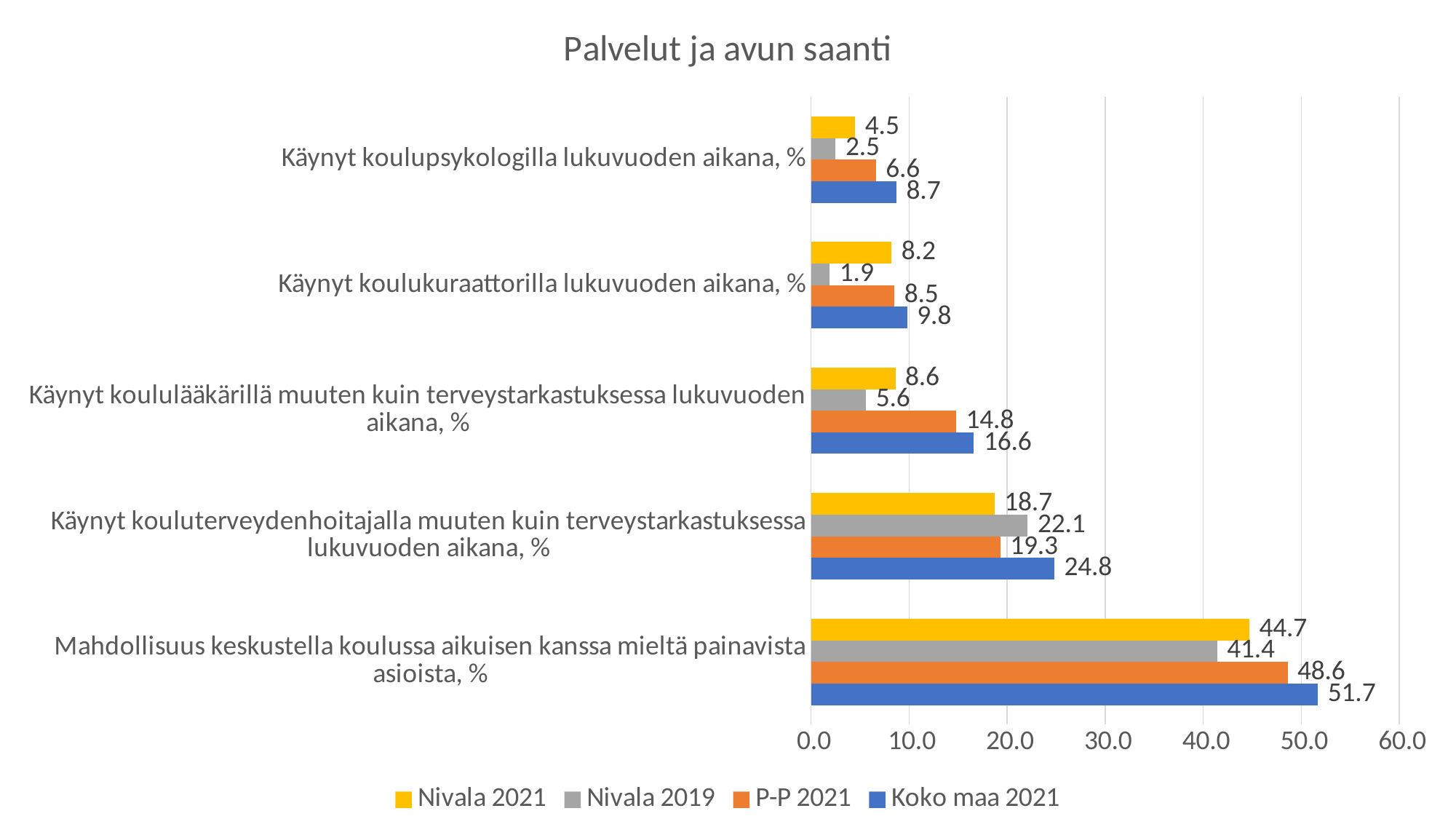
How many categories are shown on the chart? 5 Which series has the lowest value in the category "Käynyt koululääkärillä muuten kuin terveystarkastuksessa lukuvuoden aikana, %"? Nivala 2019 What is the value for Nivala 2021 in the category "Käynyt koulupsykologilla lukuvuoden aikana, %"? 4.5 Is the Koko maa 2021 value for "Mahdollisuus keskustella koulussa aikuisen kanssa mieltä painavista asioista, %" greater or less than 50.0? greater In the category "Käynyt kouluterveydenhoitajalla muuten kuin terveystarkastuksessa lukuvuoden aikana, %", which is larger: Nivala 2021 or Nivala 2019? Nivala 2019 What is the title of the chart? Palvelut ja avun saanti Which series has the highest value in the category "Käynyt kouluterveydenhoitajalla muuten kuin terveystarkastuksessa lukuvuoden aikana, %"? Koko maa 2021 What is the value for Nivala 2019 in the category "Käynyt koulukuraattorilla lukuvuoden aikana, %"? 1.9 What is the difference between the P-P 2021 and Nivala 2021 values in the category "Mahdollisuus keskustella koulussa aikuisen kanssa mieltä painavista asioista, %"? 3.9 How many series does the legend list? 4 What kind of chart is shown on the slide? bar chart What is the value for Koko maa 2021 in the category "Mahdollisuus keskustella koulussa aikuisen kanssa mieltä painavista asioista, %"? 51.7